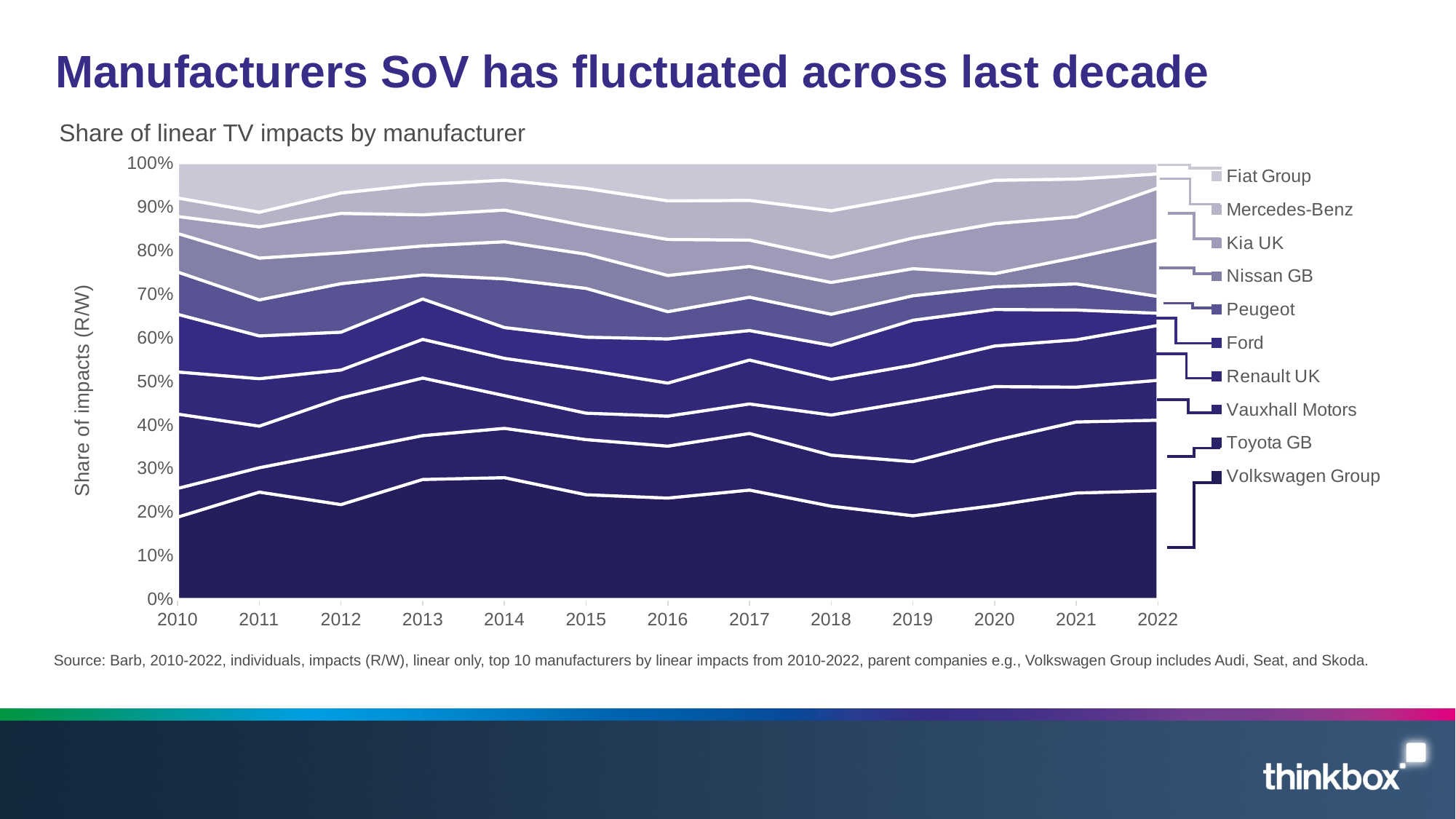
Which manufacturer forms the bottom layer of the stacked area chart? Volkswagen Group How many years are plotted along the x axis? 13 What is the label on the y axis? Share of impacts (R/W) What is the last year shown on the x axis? 2022 Is the share for Volkswagen Group in 2013 greater or less than 20%? greater Does the Volkswagen Group share rise or fall from 2019 to 2022? rise Which is larger, the Volkswagen Group share in 2013 or in 2019? 2013 What kind of chart is shown on the slide? Stacked area chart What is the first year shown on the x axis? 2010 Is the share for Volkswagen Group in 2022 greater or less than 30%? less Is the share for Volkswagen Group in 2010 greater or less than 20%? less How many manufacturers does the legend list? 10